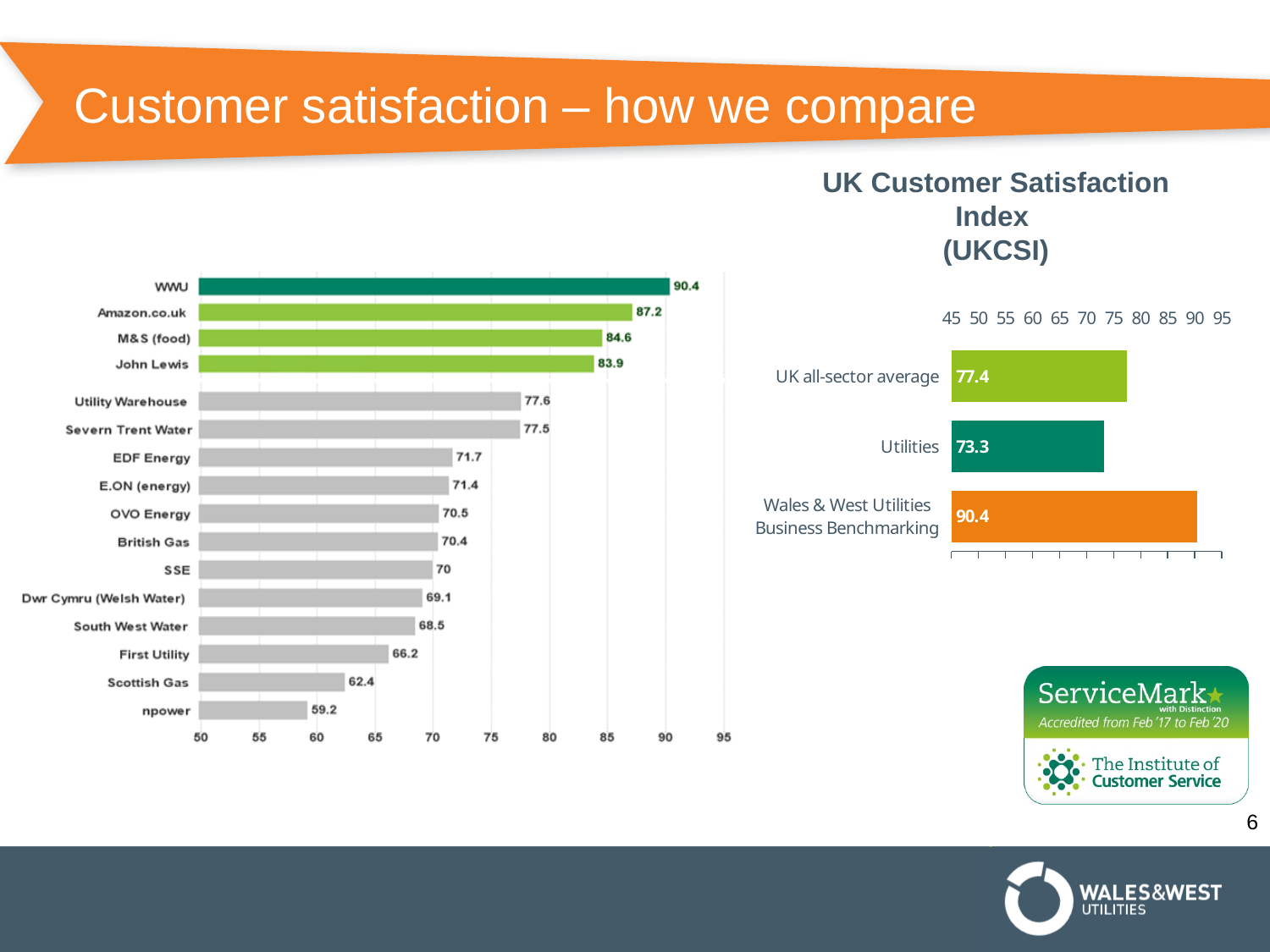
How many categories are shown in the left-hand bar chart? 16 In the UK Customer Satisfaction Index (UKCSI) chart, what is the value for Wales & West Utilities Business Benchmarking? 90.4 In the left-hand bar chart, which category has the lowest value? npower In the UK Customer Satisfaction Index (UKCSI) chart, what is the value for Utilities? 73.3 In the left-hand bar chart, which category has the highest value? WWU In the left-hand bar chart, what is the difference between the values for WWU and npower? 31.2 In the left-hand bar chart, which has the larger value, EDF Energy or Scottish Gas? EDF Energy What kind of chart is the left-hand chart? Bar chart In the UK Customer Satisfaction Index (UKCSI) chart, what is the difference between the UK all-sector average and Utilities? 4.1 In the left-hand bar chart, what is the value for Amazon.co.uk? 87.2 How many categories are shown in the UK Customer Satisfaction Index (UKCSI) chart? 3 In the left-hand bar chart, what is the value for Dwr Cymru (Welsh Water)? 69.1